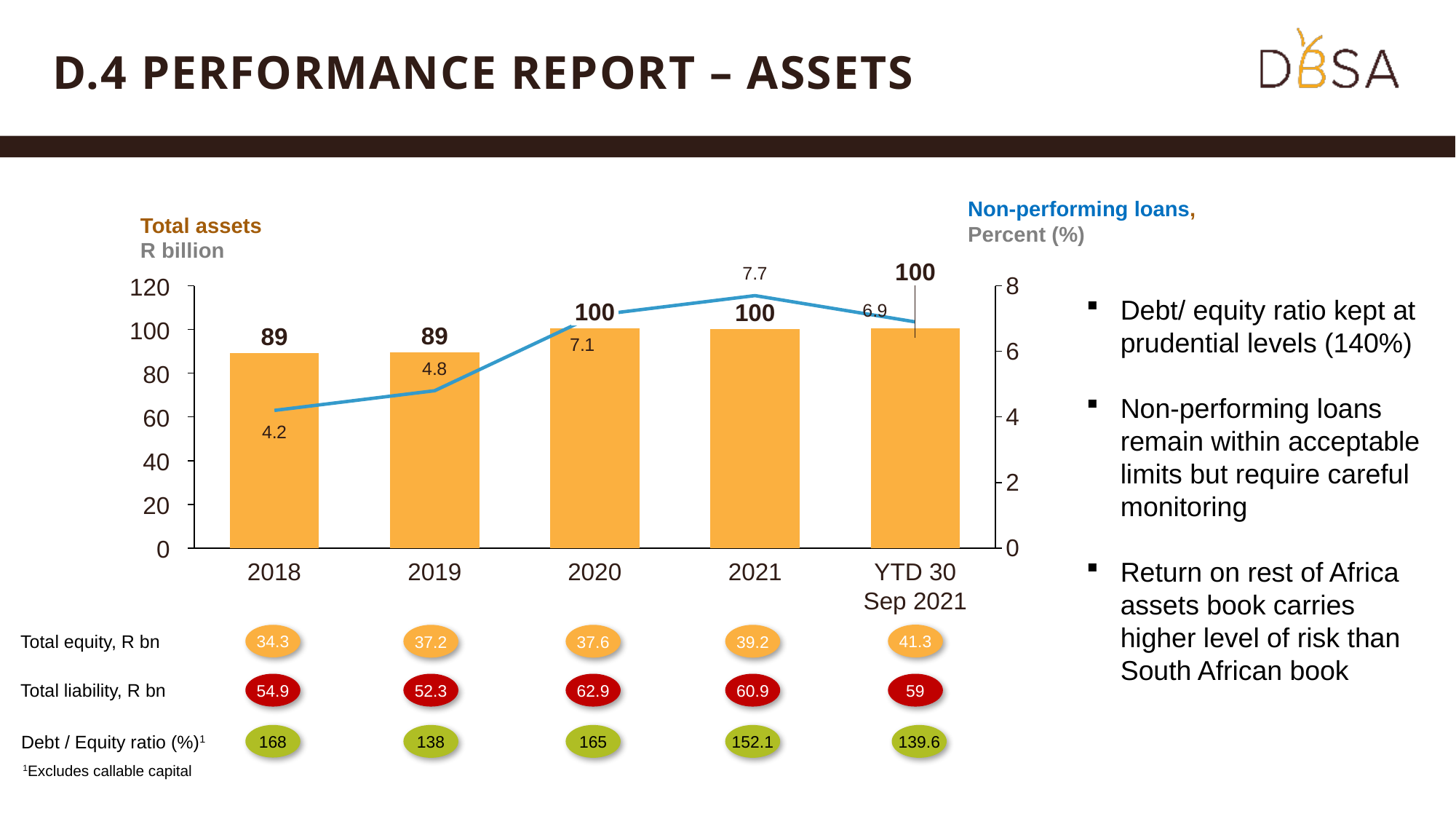
Do the total assets values rise or fall from 2018 to 2020? rise What is the difference in non-performing loans percentage between 2020 and 2019? 2.3 What is the total assets value (R billion) for 2020? 100 What is the difference in total assets (R billion) between 2020 and 2019? 11 What is the non-performing loans percentage for YTD 30 Sep 2021? 6.9 What is the non-performing loans percentage for 2021? 7.7 What is the total assets value (R billion) for 2018? 89 What unit is given for the total assets bars in the chart? R billion How many periods are shown on the x axis of the chart? 5 Which has a higher non-performing loans percentage, 2019 or 2020? 2020 In which year is the non-performing loans percentage lowest? 2018 In which year is the non-performing loans percentage highest? 2021